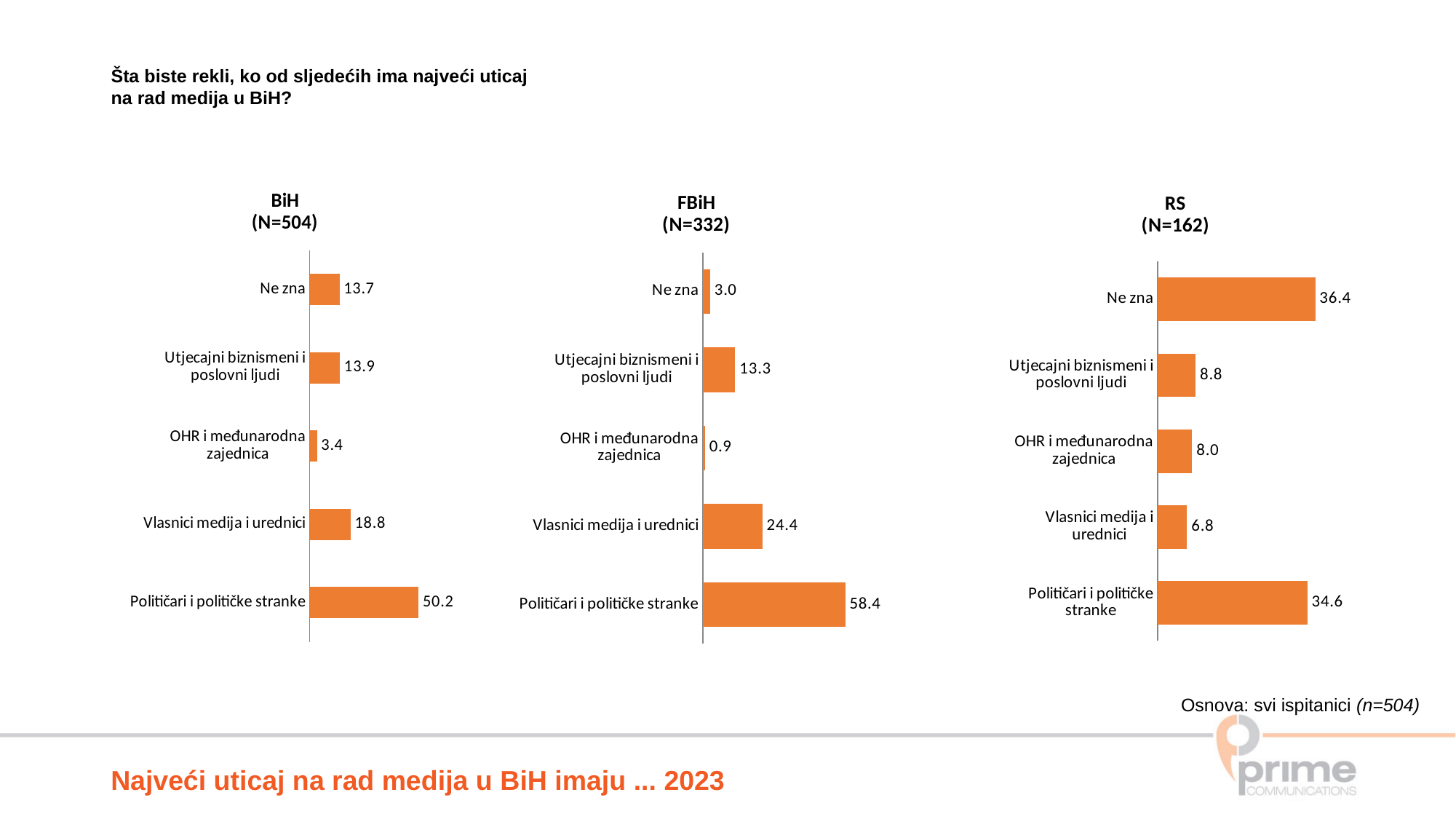
In the RS (N=162) chart, what is the difference between Ne zna and Političari i političke stranke? 1.8 In the BiH (N=504) chart, what is the value for Političari i političke stranke? 50.2 In the BiH (N=504) chart, what is the difference between Političari i političke stranke and Vlasnici medija i urednici? 31.4 In the RS (N=162) chart, which category has the highest value? Ne zna In the BiH (N=504) chart, which category has the lowest value? OHR i međunarodna zajednica In the RS (N=162) chart, what is the value for Ne zna? 36.4 How many charts are shown on the slide? 3 What type of chart is the BiH (N=504) chart? Bar chart How many categories are shown in the RS (N=162) chart? 5 In the FBiH (N=332) chart, which is larger: Utjecajni biznismeni i poslovni ljudi or Ne zna? Utjecajni biznismeni i poslovni ljudi In the FBiH (N=332) chart, which category has the lowest value? OHR i međunarodna zajednica In the FBiH (N=332) chart, what is the value for Vlasnici medija i urednici? 24.4